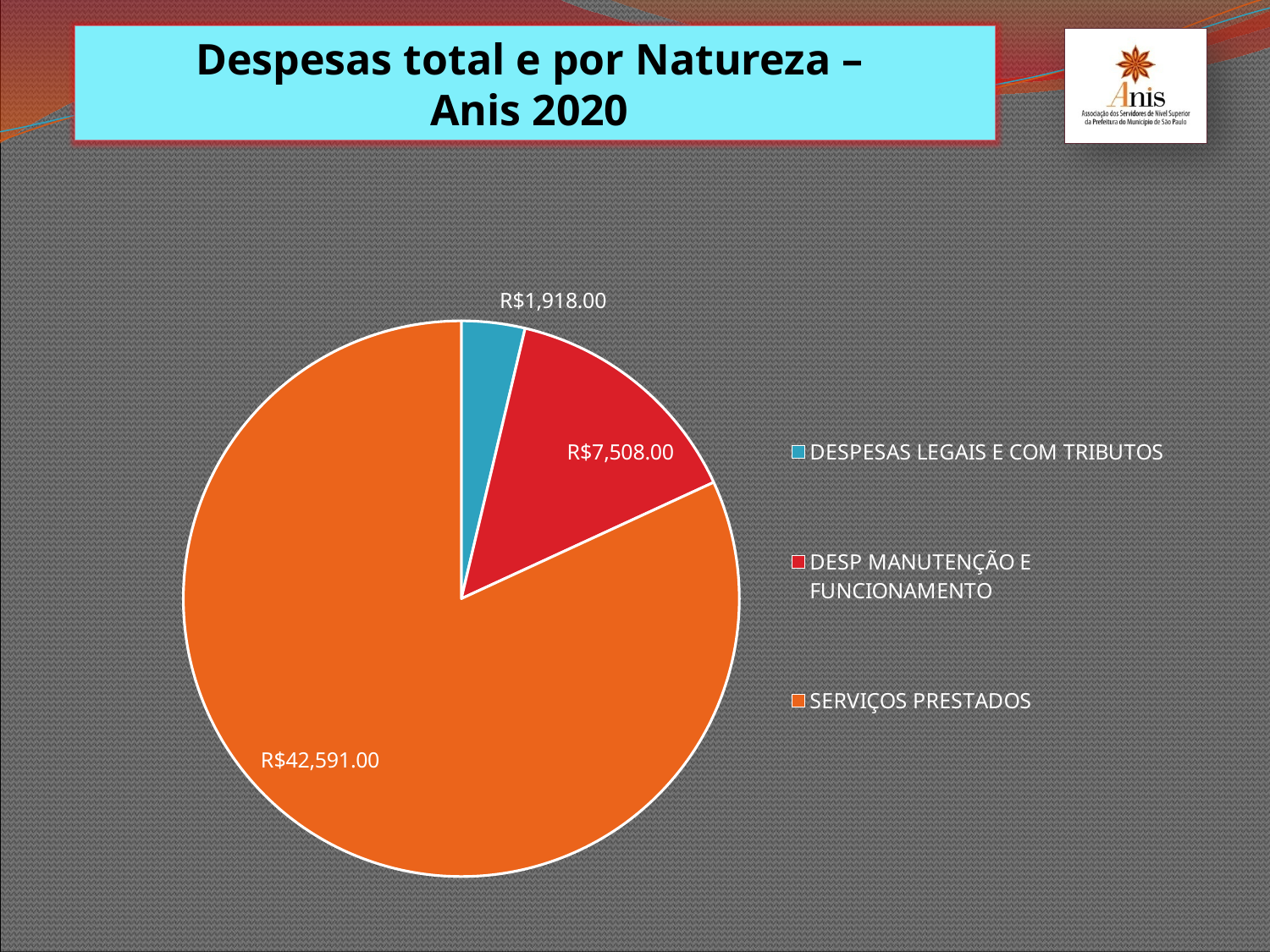
What is the total of all three slices of the pie? R$52,017.00 Which category has the smallest slice of the pie? DESPESAS LEGAIS E COM TRIBUTOS How many categories does the pie chart show? 3 What is the value for SERVIÇOS PRESTADOS? R$42,591.00 Which category has the largest slice of the pie? SERVIÇOS PRESTADOS What is the title of the slide containing the chart? Despesas total e por Natureza – Anis 2020 What is the value for DESP MANUTENÇÃO E FUNCIONAMENTO? R$7,508.00 What is the difference between the values for SERVIÇOS PRESTADOS and DESP MANUTENÇÃO E FUNCIONAMENTO? R$35,083.00 What is the difference between the values for DESP MANUTENÇÃO E FUNCIONAMENTO and DESPESAS LEGAIS E COM TRIBUTOS? R$5,590.00 What is the value for DESPESAS LEGAIS E COM TRIBUTOS? R$1,918.00 What kind of chart is shown on the slide? Pie chart Which is larger, the value for DESP MANUTENÇÃO E FUNCIONAMENTO or the value for DESPESAS LEGAIS E COM TRIBUTOS? DESP MANUTENÇÃO E FUNCIONAMENTO